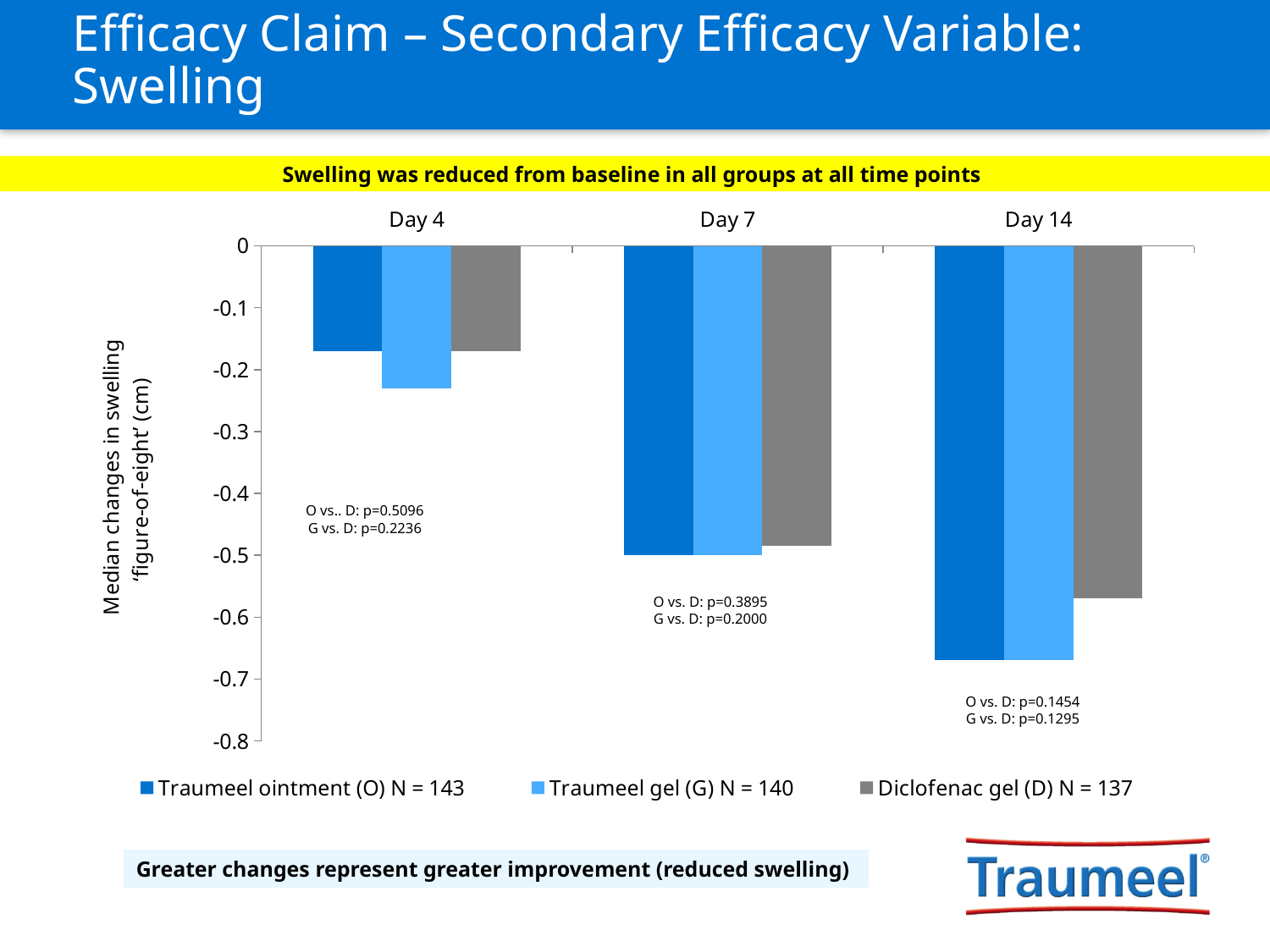
What is the N given in the legend for Traumeel gel (G)? 140 What kind of chart is shown on the slide? bar chart How many series does the legend list? 3 At Day 4, which series has the lowest (most negative) value? Traumeel gel (G) How many time-point categories are shown on the x axis? 3 Is the value for Traumeel ointment (O) at Day 4 greater or less than -0.2? greater Do the median changes in swelling rise or fall (become more negative) from Day 4 to Day 14? fall What p-value is shown for O vs. D at Day 7? p=0.3895 Is the value for Diclofenac gel (D) at Day 14 greater or less than -0.5? less Is the value for Traumeel ointment (O) at Day 14 greater or less than -0.6? less At Day 14, which is larger (less negative): the value for Diclofenac gel (D) or Traumeel ointment (O)? Diclofenac gel (D)